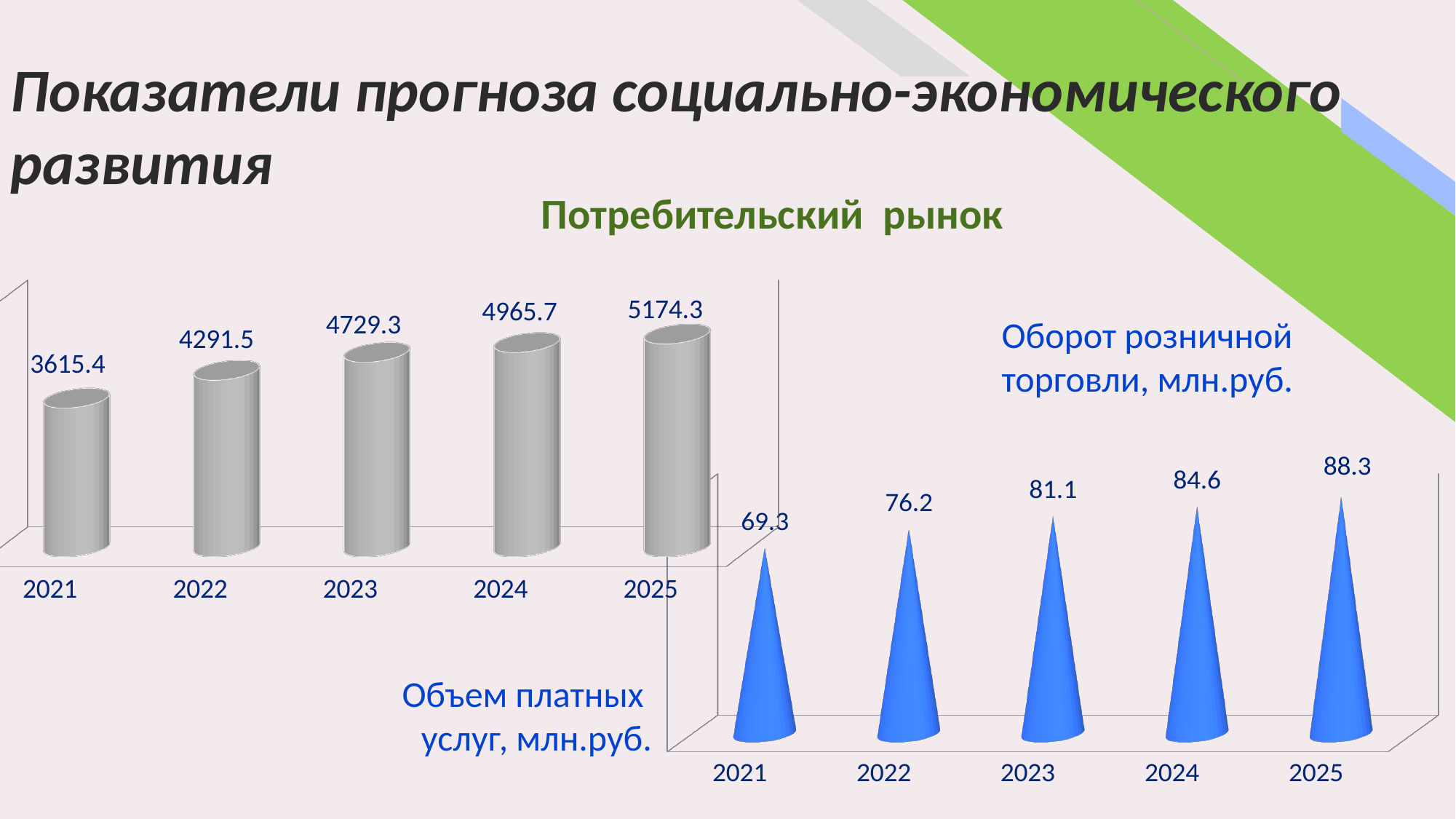
In the right chart with blue cones, what is the value for 2023? 81.1 In the left chart with grey cylinders, what is the difference between the values for 2022 and 2021? 676.1 In the right chart with blue cones, what is the difference between the values for 2025 and 2024? 3.7 How many years are shown in the right chart with blue cones? 5 Do the values in the left chart with grey cylinders rise or fall from 2021 to 2025? rise What kind of chart is the left chart with grey cylinders? bar chart In the left chart with grey cylinders, what is the value for 2025? 5174.3 In the right chart with blue cones, which year has the lowest value? 2021 In the left chart with grey cylinders, what is the value for 2021? 3615.4 In the right chart with blue cones, what is the value for 2021? 69.3 In the left chart with grey cylinders, which year has the highest value? 2025 In the left chart with grey cylinders, which is larger, the value for 2023 or the value for 2024? 2024